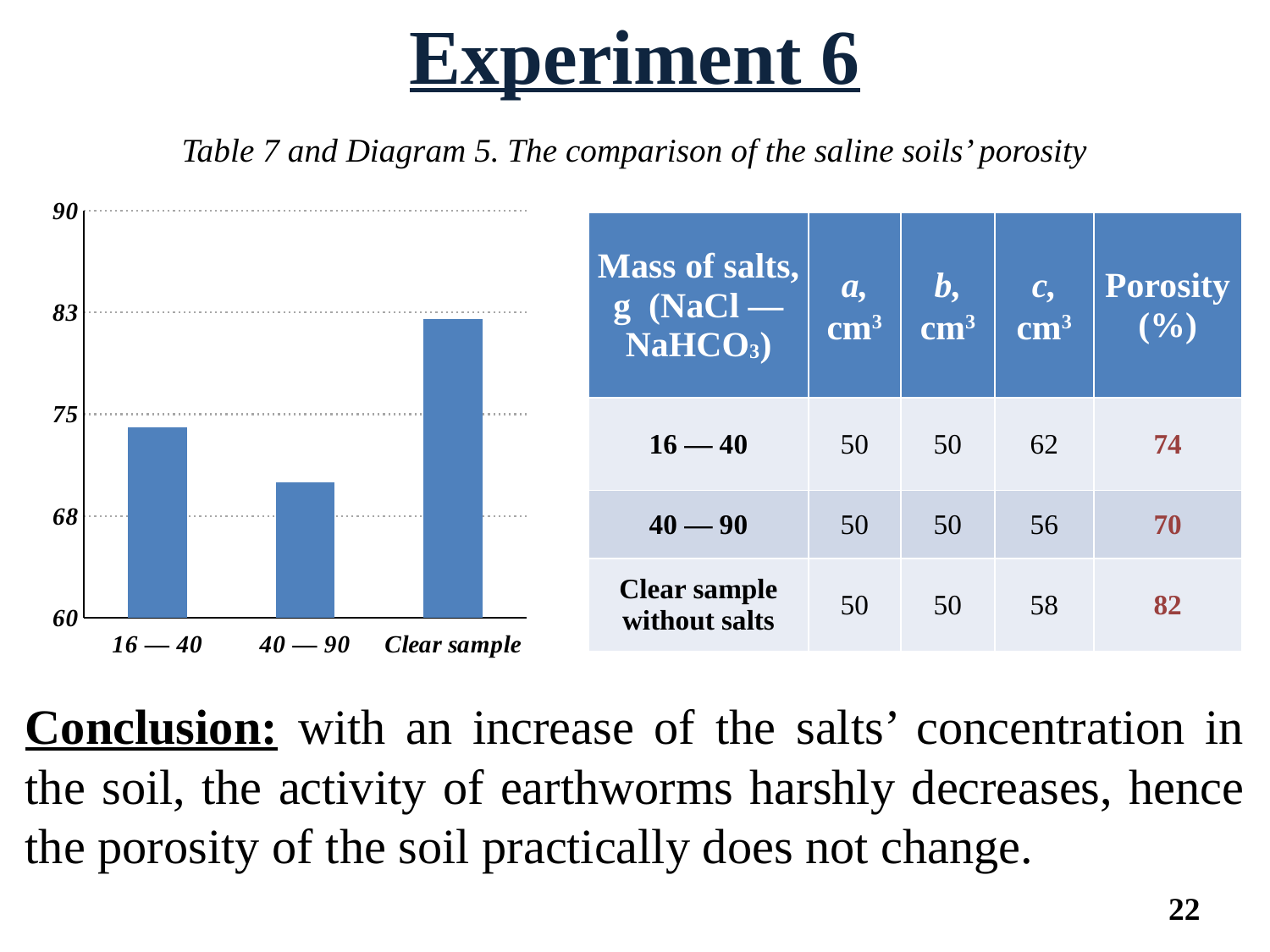
What kind of chart is shown on the left of the slide? bar chart Which bar is taller, 40 — 90 or Clear sample? Clear sample How many bars does the chart show? 3 Does the bar height rise or fall from 16 — 40 to 40 — 90? fall Which category has the tallest bar in the chart? Clear sample Is the value for Clear sample greater or less than 75? greater Which bar is taller, 16 — 40 or 40 — 90? 16 — 40 Which category has the shortest bar in the chart? 40 — 90 Is the value for 40 — 90 greater or less than 68? greater What is the highest value shown on the chart's vertical axis? 90 Is the value for 16 — 40 greater or less than 75? less What is the lowest value shown on the chart's vertical axis? 60